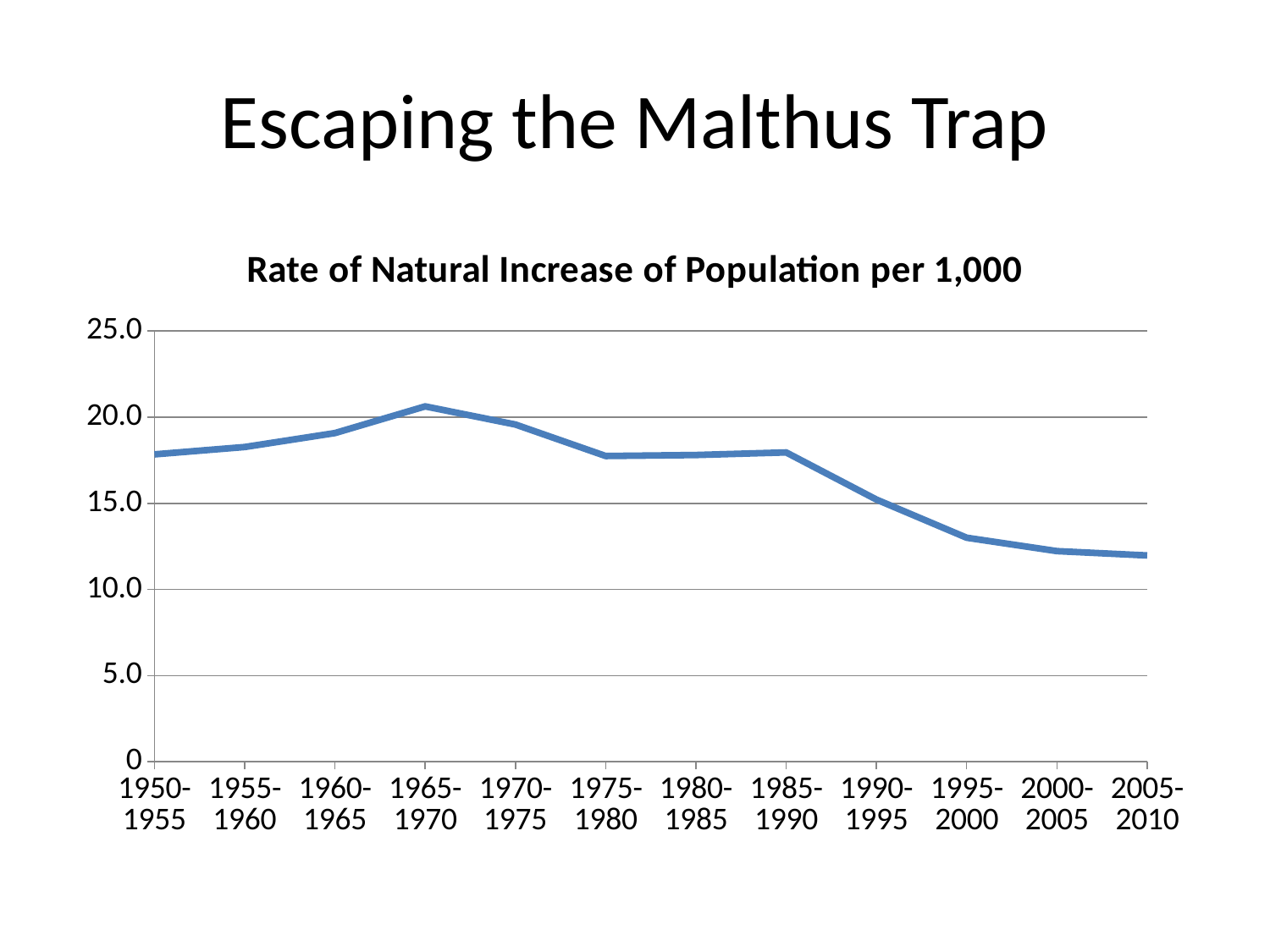
What is the title of the chart? Rate of Natural Increase of Population per 1,000 How many time periods are plotted along the x axis? 12 Is the value for 1975-1980 greater or less than 20.0? less Does the rate of natural increase rise or fall between 1985-1990 and 2005-2010? fall Is the value for 2005-2010 greater or less than 10.0? greater Which period has the highest rate of natural increase? 1965-1970 Is the value for 1995-2000 greater or less than 15.0? less Which is larger, the value for 1965-1970 or the value for 1985-1990? 1965-1970 Which is larger, the value for 1960-1965 or the value for 2000-2005? 1960-1965 What kind of chart is shown on the slide? line chart